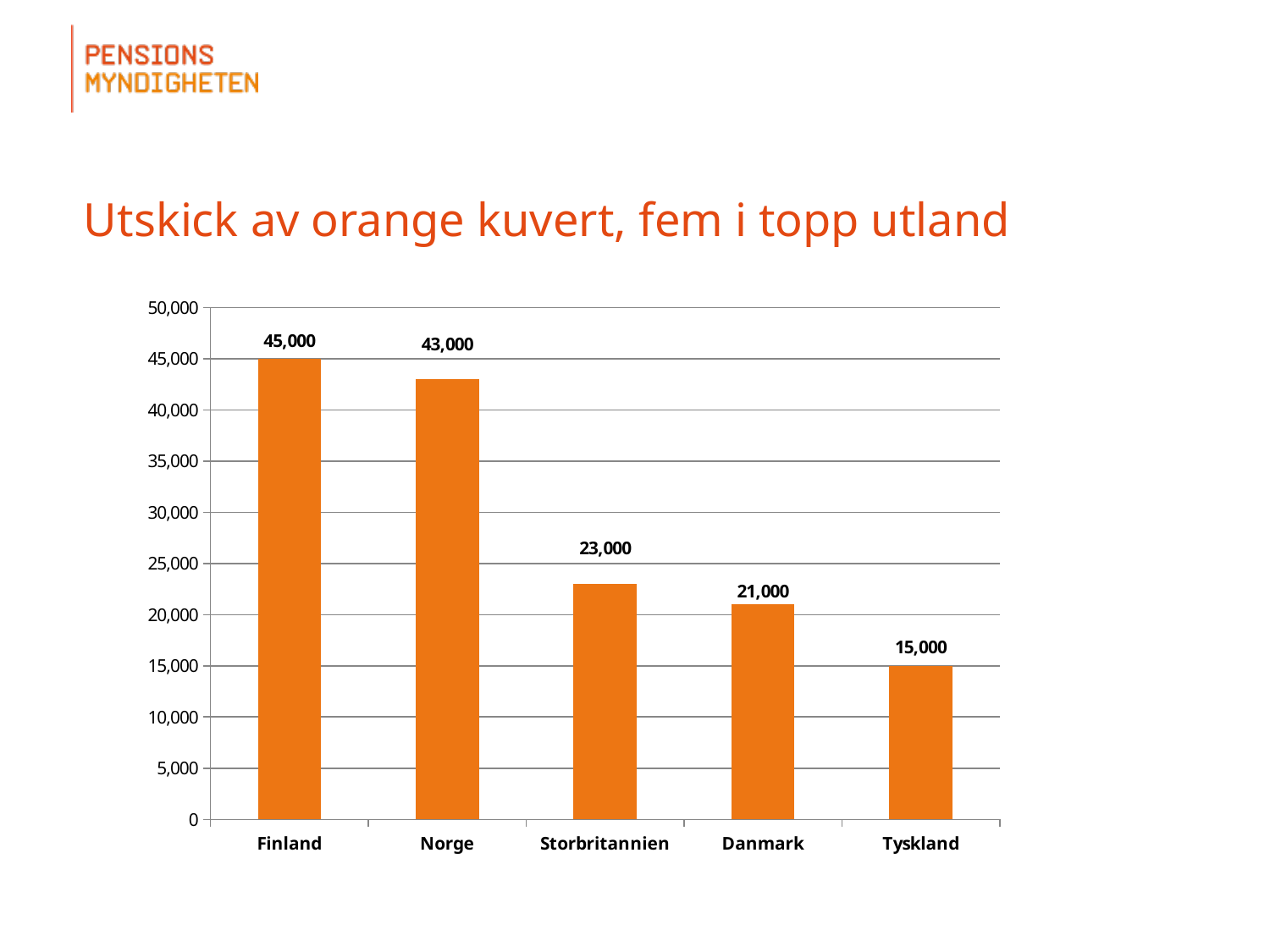
How many countries are shown in the chart? 5 What is the difference between the values for Storbritannien and Tyskland? 8,000 What is the value for Tyskland? 15,000 Which country has the highest value? Finland What is the value for Storbritannien? 23,000 What is the title of the slide? Utskick av orange kuvert, fem i topp utland Which is larger, the value for Danmark or the value for Tyskland? Danmark Which country has the lowest value? Tyskland What kind of chart is shown on the slide? Bar chart What is the difference between the values for Finland and Norge? 2,000 Is the value for Norge greater or less than 40,000? greater What is the value for Finland? 45,000